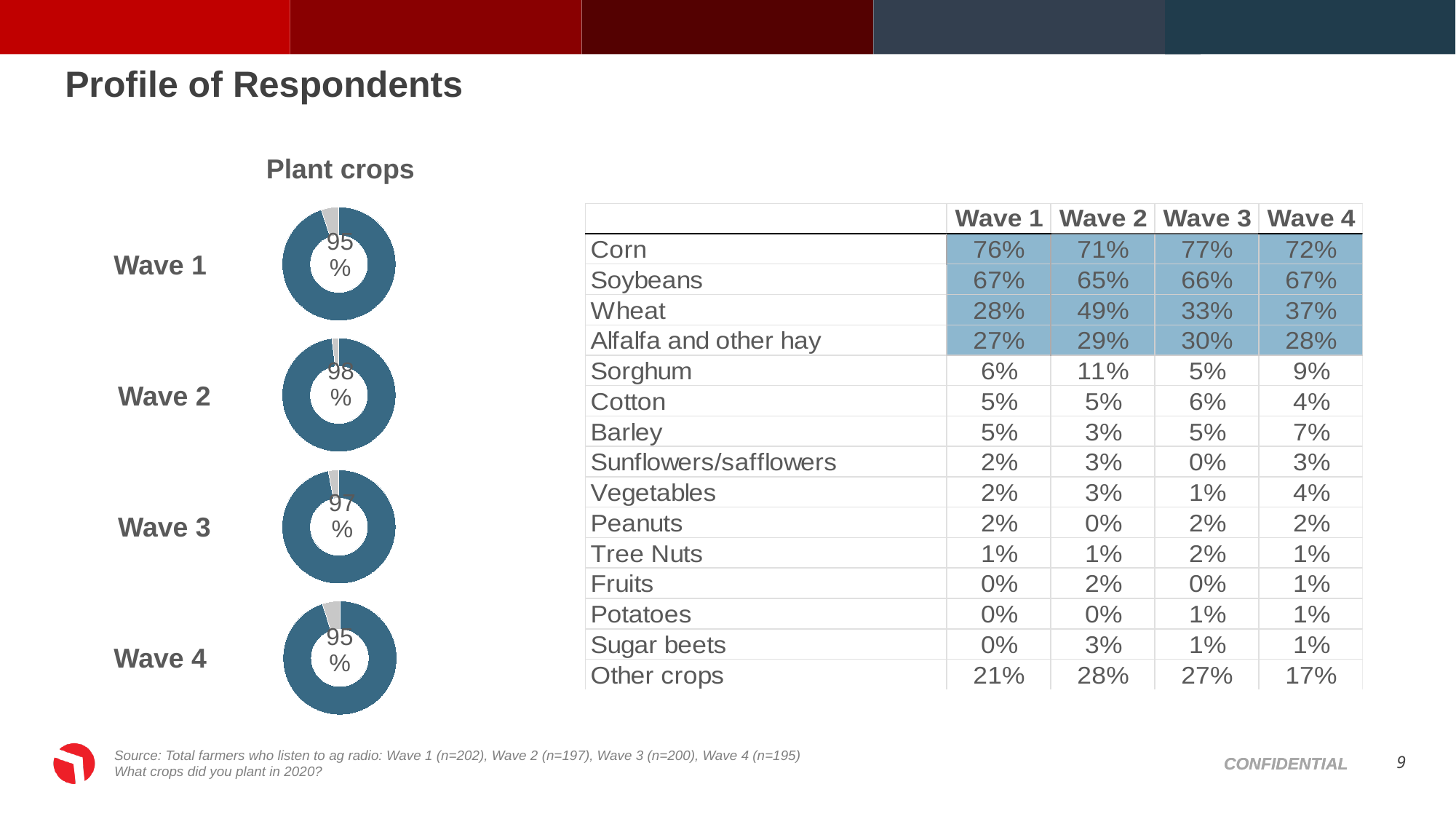
What kind of chart is used to show the Plant crops percentages for each wave? Donut (pie) chart Which wave has the highest Plant crops percentage in the donut charts? Wave 2 In the Wave 3 donut chart, what share of the ring is the dark blue segment? 97% In the Plant crops donut charts, what is the difference between the Wave 3 and Wave 4 percentages? 2 percentage points In the Plant crops donut charts, what percentage is shown for Wave 3? 97% In the Plant crops donut charts, what percentage is shown for Wave 4? 95% How many donut charts are shown under the Plant crops heading? 4 What is the title above the donut charts on the left of the slide? Plant crops In the Plant crops donut charts, what percentage is shown for Wave 2? 98% In the Plant crops donut charts, what percentage is shown for Wave 1? 95% In the Plant crops donut charts, what is the difference between the Wave 2 and Wave 1 percentages? 3 percentage points In the Plant crops donut charts, which is larger, the Wave 2 value or the Wave 3 value? Wave 2